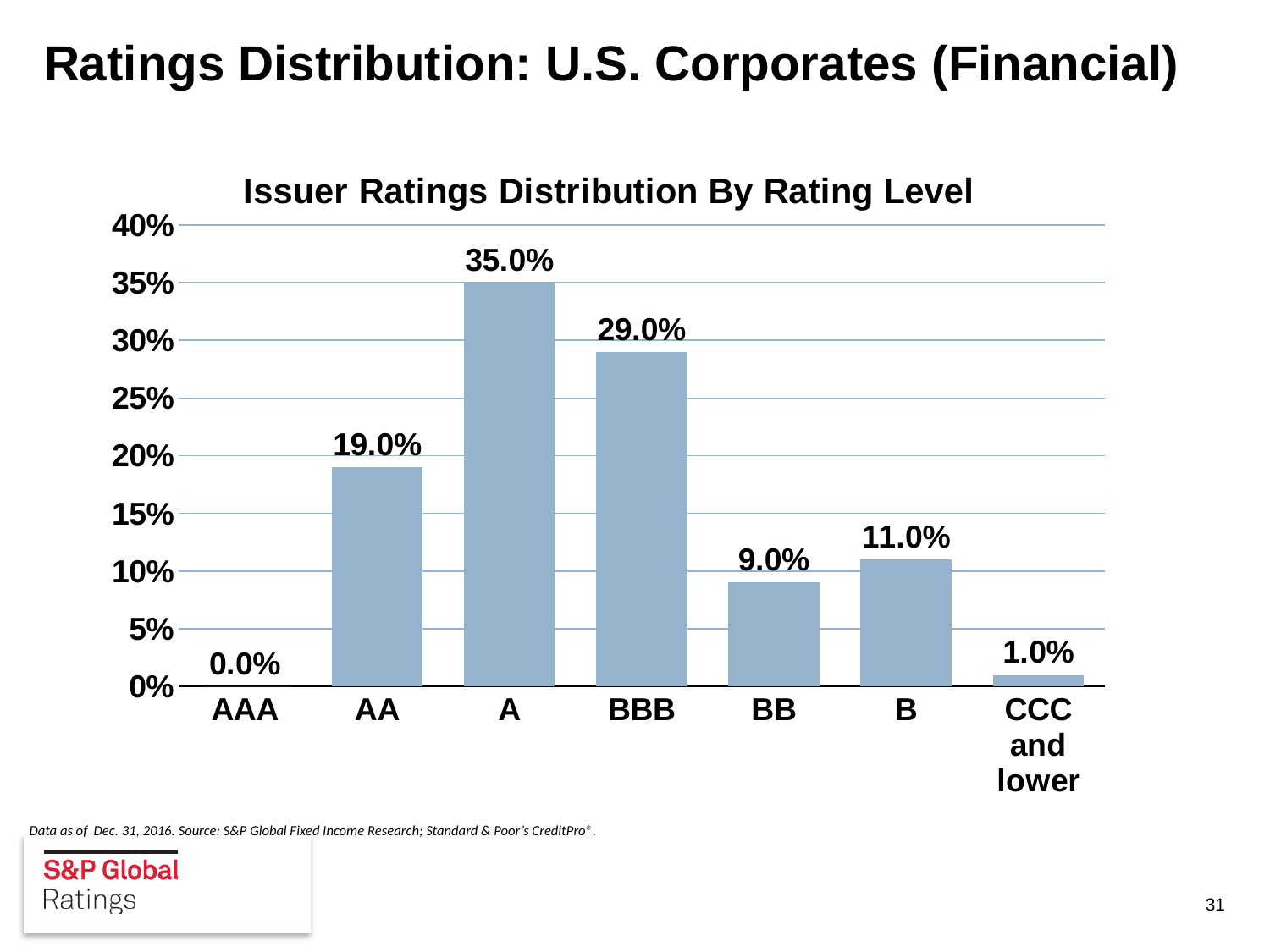
What is the title of the chart? Issuer Ratings Distribution By Rating Level What kind of chart is shown on the slide? Bar chart Which is larger, the value for BB or the value for B? B Which rating level has the highest value? A What is the value for the A rating level? 35.0% What is the difference between the values for A and BBB? 6.0% What is the value for the CCC and lower rating level? 1.0% What is the difference between the values for AA and B? 8.0% What is the value for the BBB rating level? 29.0% Which rating level has the lowest value? AAA What is the value for the AAA rating level? 0.0% How many rating levels are shown on the x axis? 7